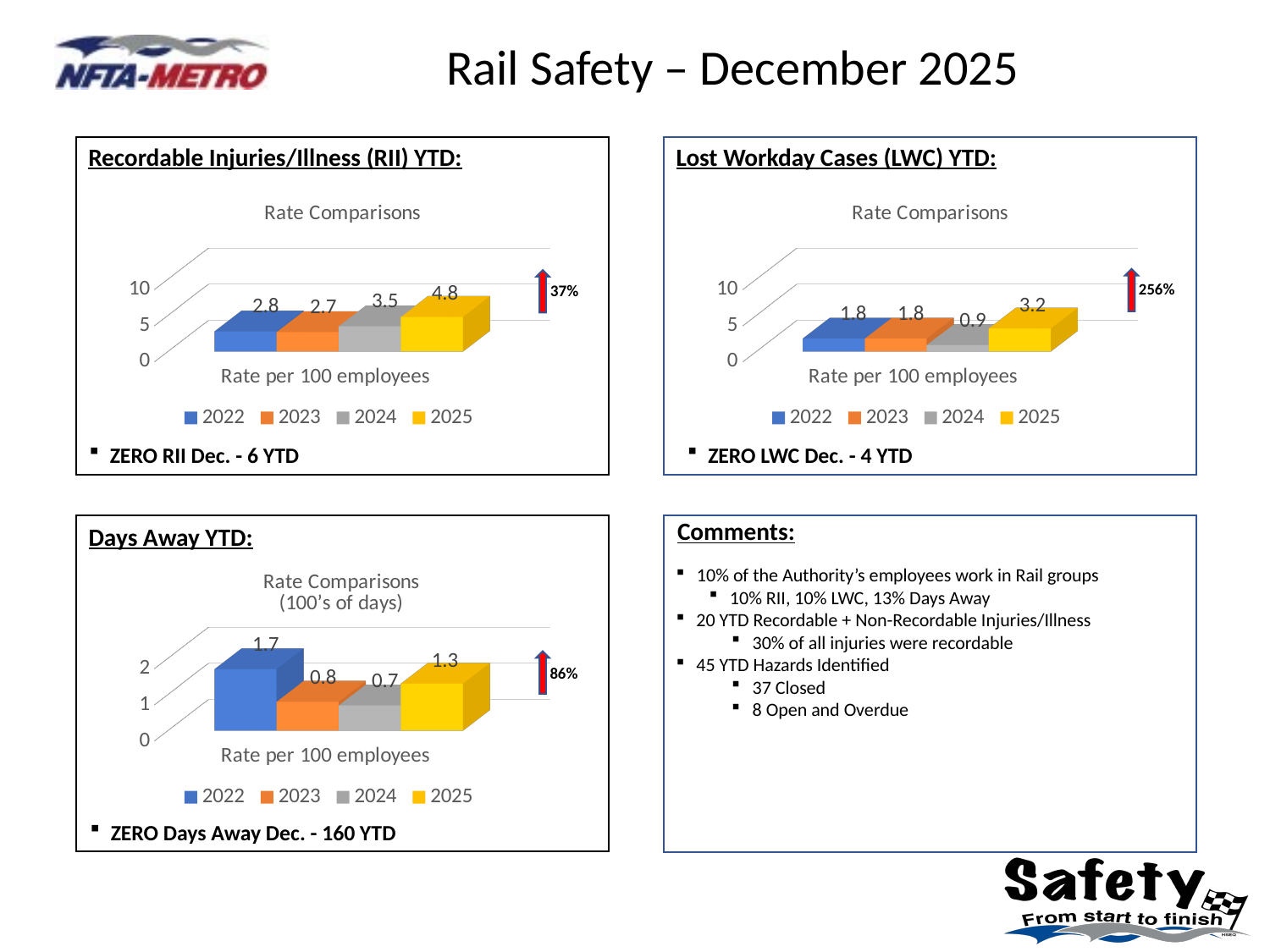
In the Lost Workday Cases (LWC) YTD chart, which year has the highest rate? 2025 How many series does the legend of the Recordable Injuries/Illness (RII) YTD chart list? 4 In the Recordable Injuries/Illness (RII) YTD chart, what is the rate per 100 employees for 2025? 4.8 In the Days Away YTD chart, is the value for 2025 larger than the value for 2023? Yes In the Lost Workday Cases (LWC) YTD chart, what is the difference between the 2025 and 2024 rates? 2.3 In the Lost Workday Cases (LWC) YTD chart, what is the rate per 100 employees for 2024? 0.9 In the Recordable Injuries/Illness (RII) YTD chart, what is the difference between the 2025 and 2024 rates? 1.3 What kind of chart is the Days Away YTD chart? Bar chart In the Recordable Injuries/Illness (RII) YTD chart, which year has the lowest rate? 2023 In the Days Away YTD chart, which year has the lowest value? 2024 In the Days Away YTD chart, what is the value for 2022? 1.7 What percentage change is shown next to the red arrow on the Lost Workday Cases (LWC) YTD chart? 256%